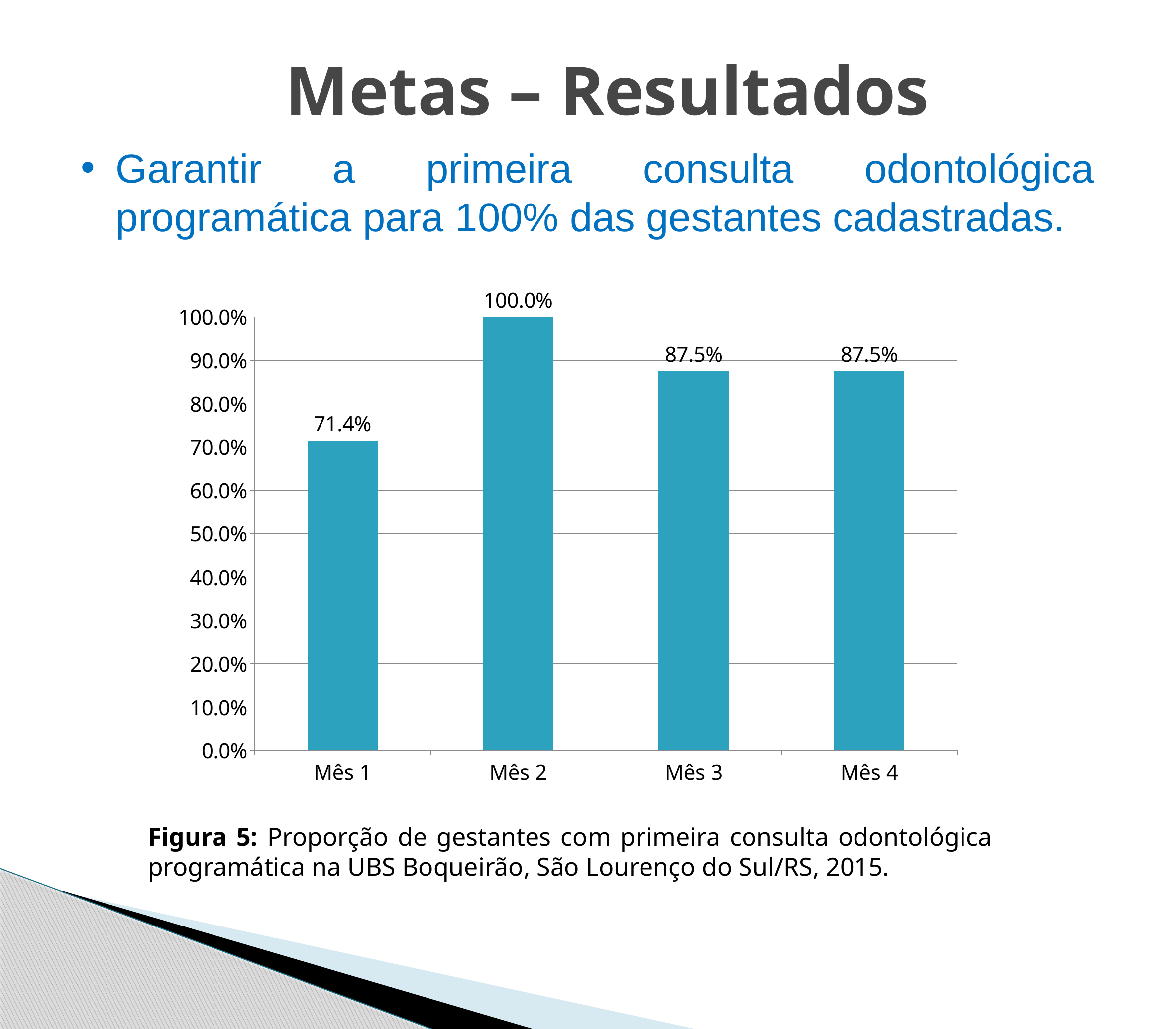
What kind of chart is shown on the slide? Bar chart Which month has the highest value? Mês 2 What is the value for Mês 2? 100.0% What is the difference between the values for Mês 3 and Mês 1? 16.1% Which is larger, the value for Mês 1 or the value for Mês 3? Mês 3 Which month has the lowest value? Mês 1 What is the difference between the values for Mês 2 and Mês 1? 28.6% What is the value for Mês 3? 87.5% What is the figure number given in the caption below the chart? Figura 5 What is the value for Mês 4? 87.5% How many months are shown on the x axis? 4 What is the value for Mês 1? 71.4%